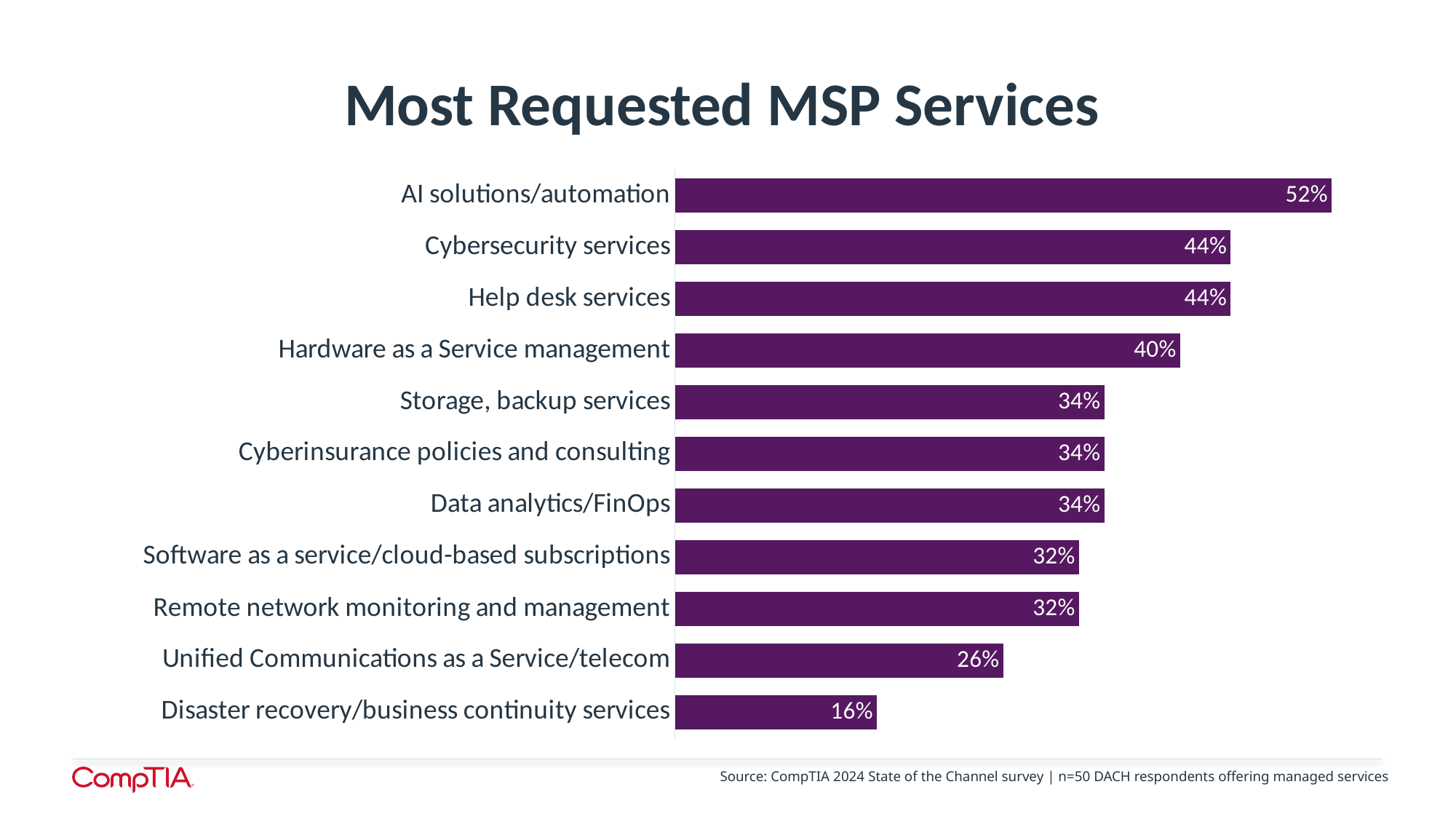
What is the value for Disaster recovery/business continuity services? 16% Which service has the lowest value on the chart? Disaster recovery/business continuity services Which service has the highest value on the chart? AI solutions/automation What is the title of the chart? Most Requested MSP Services What percentage is shown for AI solutions/automation? 52% What is the difference between the values for AI solutions/automation and Cybersecurity services? 8% What is the difference between the values for Hardware as a Service management and Disaster recovery/business continuity services? 24% What percentage is shown for Unified Communications as a Service/telecom? 26% How many services are listed on the chart? 11 What is the value for Hardware as a Service management? 40% Which has a larger value, Storage, backup services or Remote network monitoring and management? Storage, backup services What kind of chart is shown on the slide? Bar chart